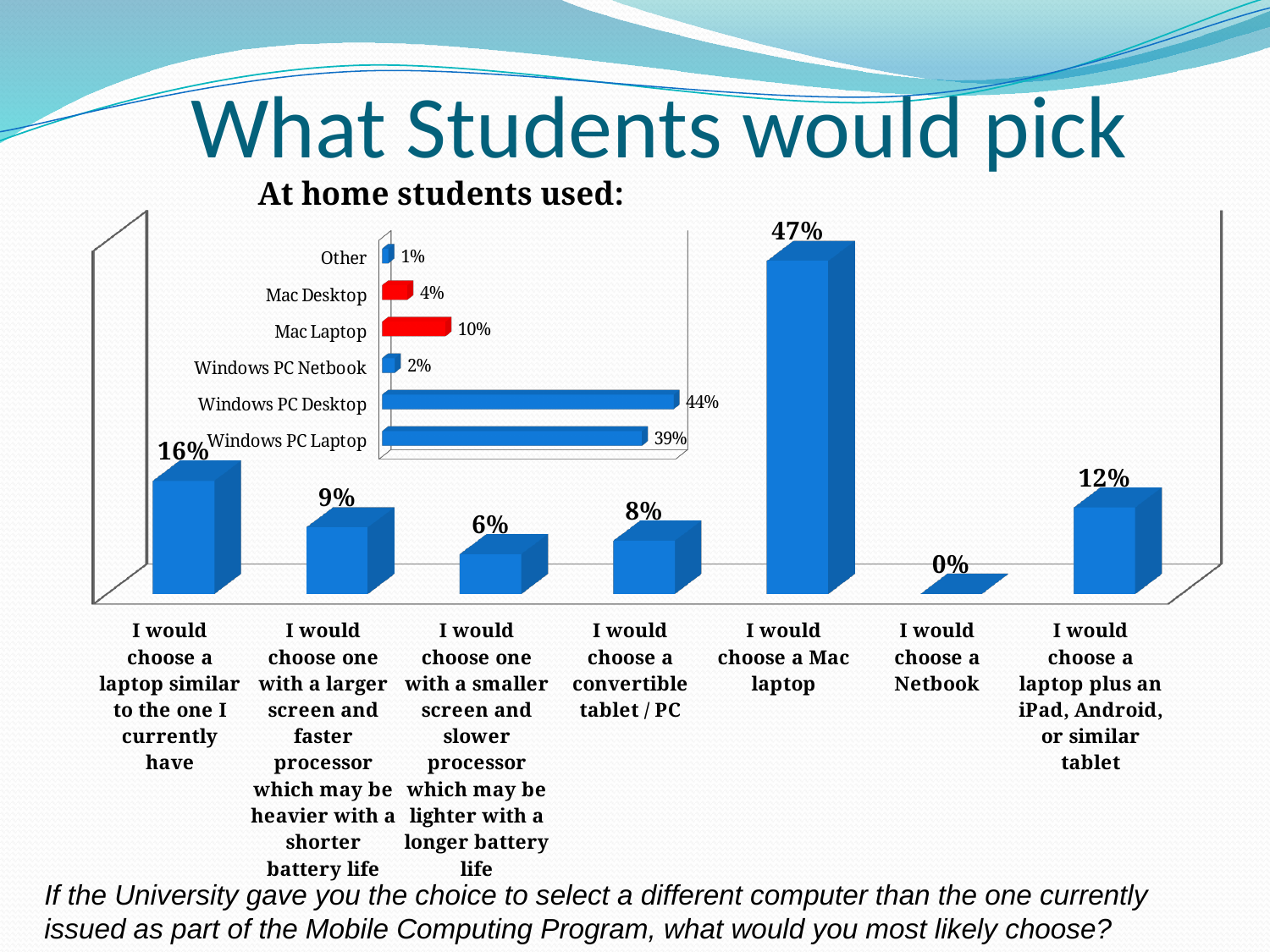
In the large 'What Students would pick' chart, what percentage would choose a laptop plus an iPad, Android, or similar tablet? 12% In the inset 'At home students used' chart, what is the difference between Windows PC Desktop and Windows PC Laptop? 5% In the large 'What Students would pick' chart, which option has the highest percentage? I would choose a Mac laptop In the large 'What Students would pick' chart, what percentage of students would choose a Mac laptop? 47% In the large 'What Students would pick' chart, what is the difference between the percentage choosing a laptop similar to the one they currently have and the percentage choosing a convertible tablet / PC? 8% In the inset 'At home students used' chart, what percentage of students used a Windows PC Desktop at home? 44% In the large 'What Students would pick' chart, which is larger: the percentage choosing one with a larger screen and faster processor, or the percentage choosing one with a smaller screen and slower processor? Larger screen and faster processor (9%) What type of chart is the inset 'At home students used' chart? Bar chart How many options are shown in the large 'What Students would pick' chart? 7 In the large 'What Students would pick' chart, which option has the lowest percentage? I would choose a Netbook In the inset 'At home students used' chart, which category has the lowest percentage? Other In the inset 'At home students used' chart, what percentage used a Mac Laptop at home? 10%